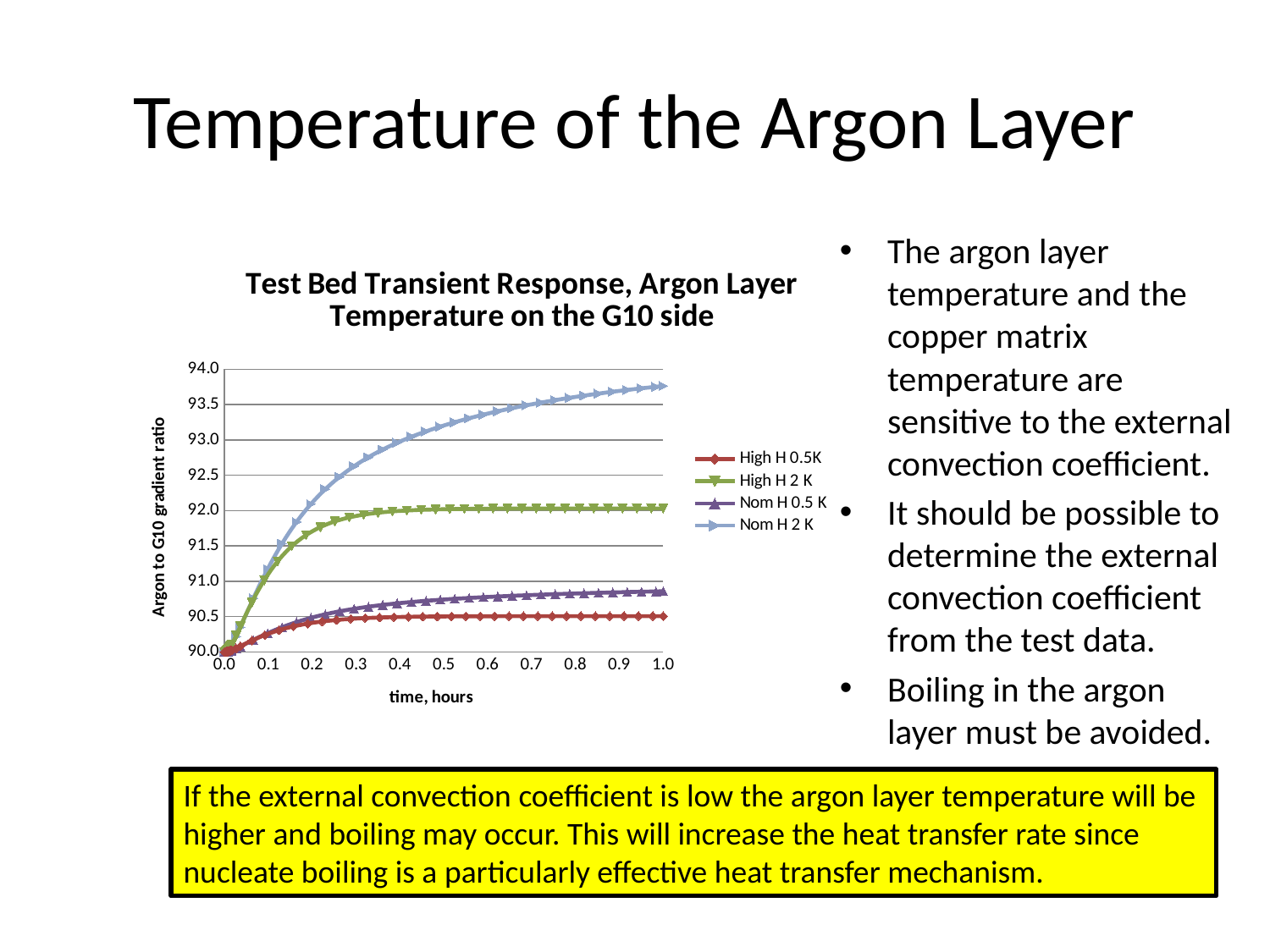
Is the value for High H 2 K at 1.0 hours greater or less than 92.5? less Which series has the lowest value at 1.0 hours? High H 0.5K Is the value for Nom H 2 K at 1.0 hours greater or less than 93.5? greater Which series has the highest value at 1.0 hours? Nom H 2 K Do the values for Nom H 2 K rise or fall as time increases from 0.0 to 1.0 hours? rise What kind of chart is shown on the slide? line chart Which series has the larger value at 0.5 hours, Nom H 2 K or High H 2 K? Nom H 2 K Is the value for High H 0.5K at 1.0 hours greater or less than 91.0? less What is the title of the chart? Test Bed Transient Response, Argon Layer Temperature on the G10 side What is the label of the x axis of the chart? time, hours How many series does the chart legend list? 4